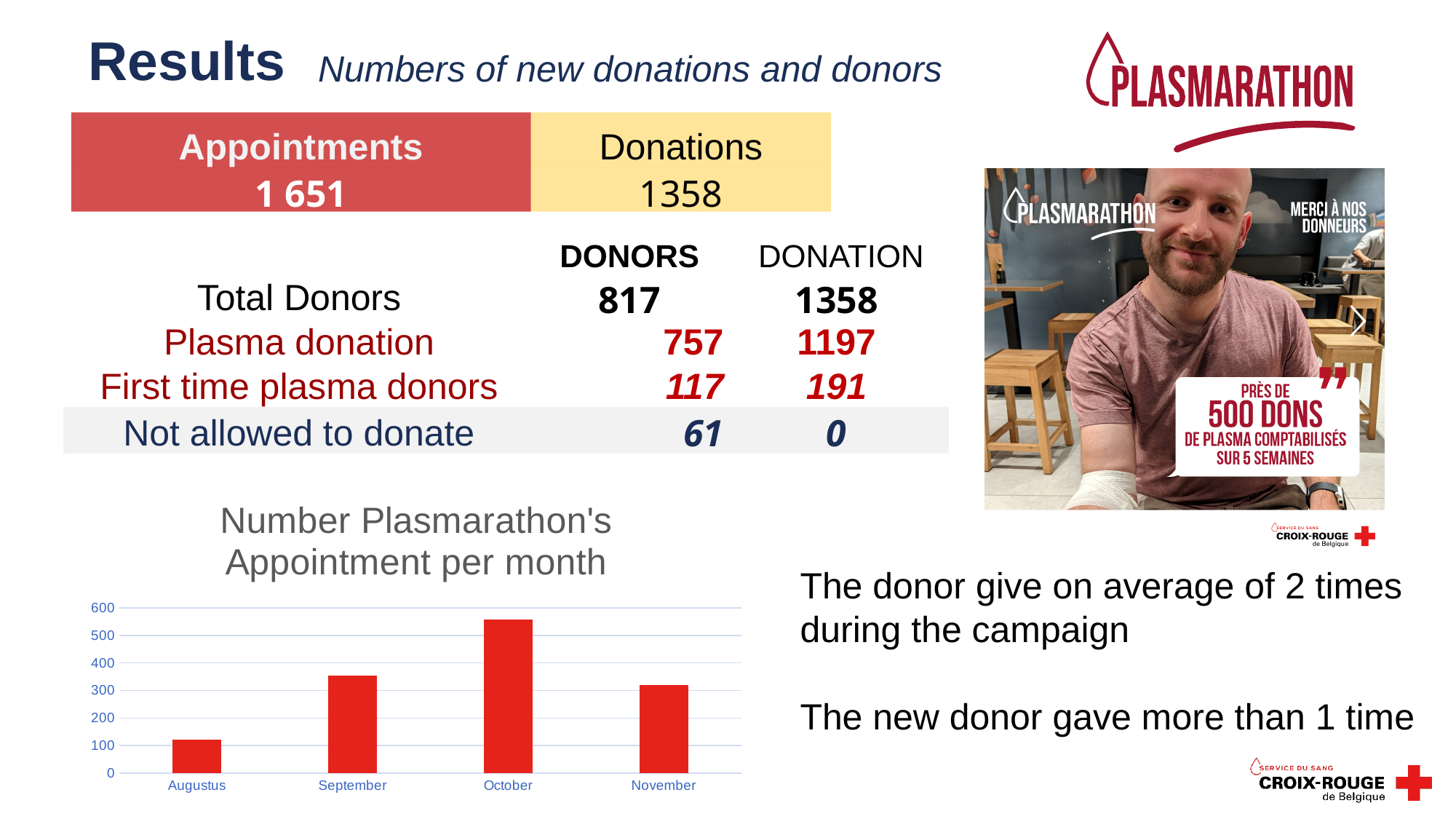
In the 'Number Plasmarathon's Appointment per month' chart, which month has more appointments, Augustus or November? November In the 'Number Plasmarathon's Appointment per month' chart, is the value for Augustus greater or less than 200? less In the 'Number Plasmarathon's Appointment per month' chart, is the value for October greater or less than 500? greater In the 'Number Plasmarathon's Appointment per month' chart, do the values rise or fall from Augustus to October? rise In the 'Number Plasmarathon's Appointment per month' chart, is the value for November greater or less than 400? less How many months are shown on the x axis of the 'Number Plasmarathon's Appointment per month' chart? 4 What is the title of the bar chart at the bottom left of the slide? Number Plasmarathon's Appointment per month Which month has the highest number of appointments in the 'Number Plasmarathon's Appointment per month' chart? October What kind of chart is 'Number Plasmarathon's Appointment per month'? bar chart In the 'Number Plasmarathon's Appointment per month' chart, which month has more appointments, October or September? October Which month has the lowest number of appointments in the 'Number Plasmarathon's Appointment per month' chart? Augustus